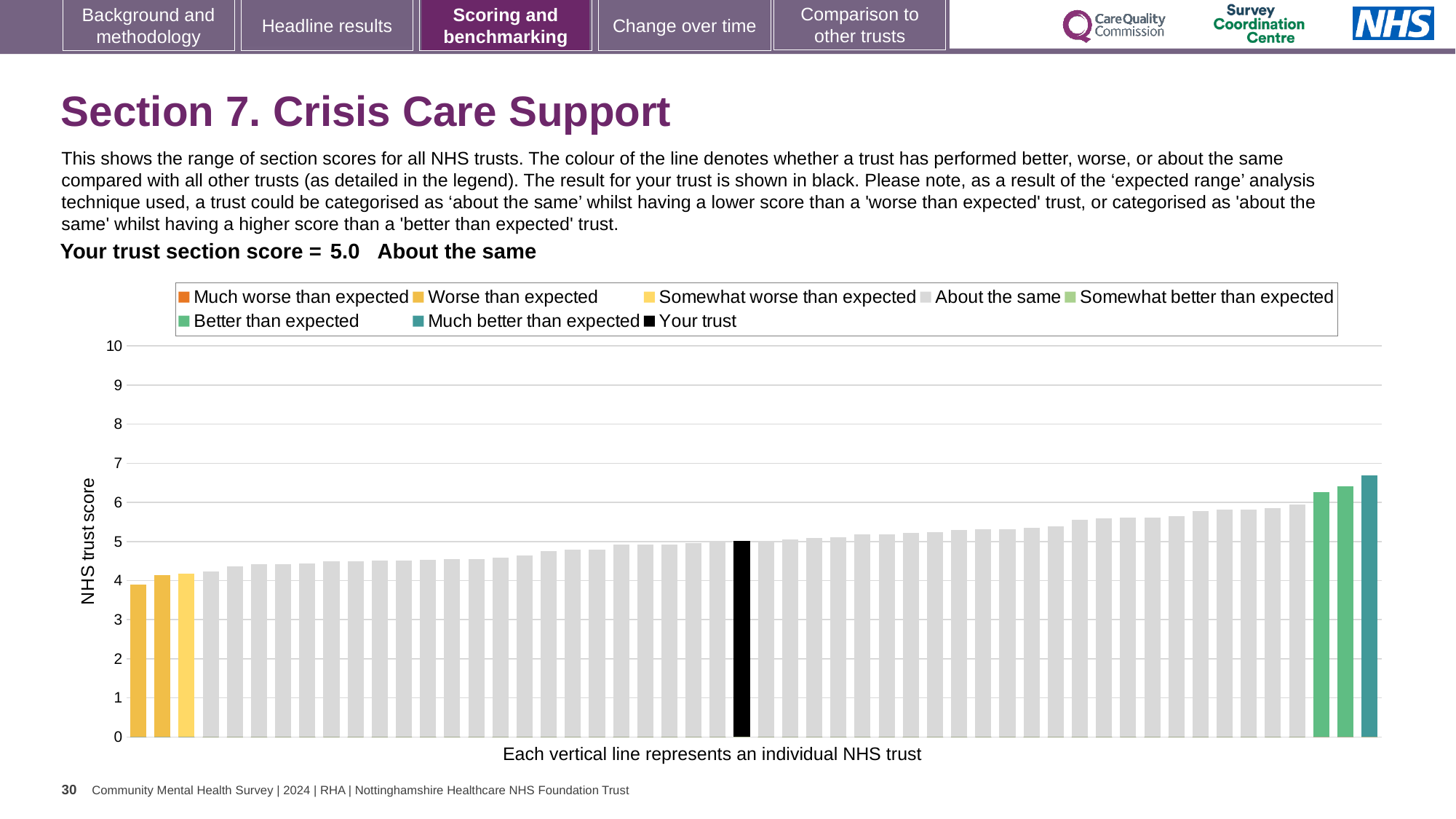
What is the section score for your trust shown on the slide? 5.0 Which category is your trust placed in for this section? About the same Is the value of the tallest bar greater or less than 6? greater How many bars are coloured green or teal (better than expected categories)? 3 Do the bar values rise or fall from left to right along the x axis? rise Is the value of the shortest bar greater or less than 5? less What colour is used for the 'Your trust' bar? black What kind of chart is shown on the slide? bar chart What is the label on the y axis of the chart? NHS trust score Which legend category does the tallest bar belong to? Much better than expected Is the value of the black 'Your trust' bar greater or less than 6? less How many entries does the chart legend list? 8